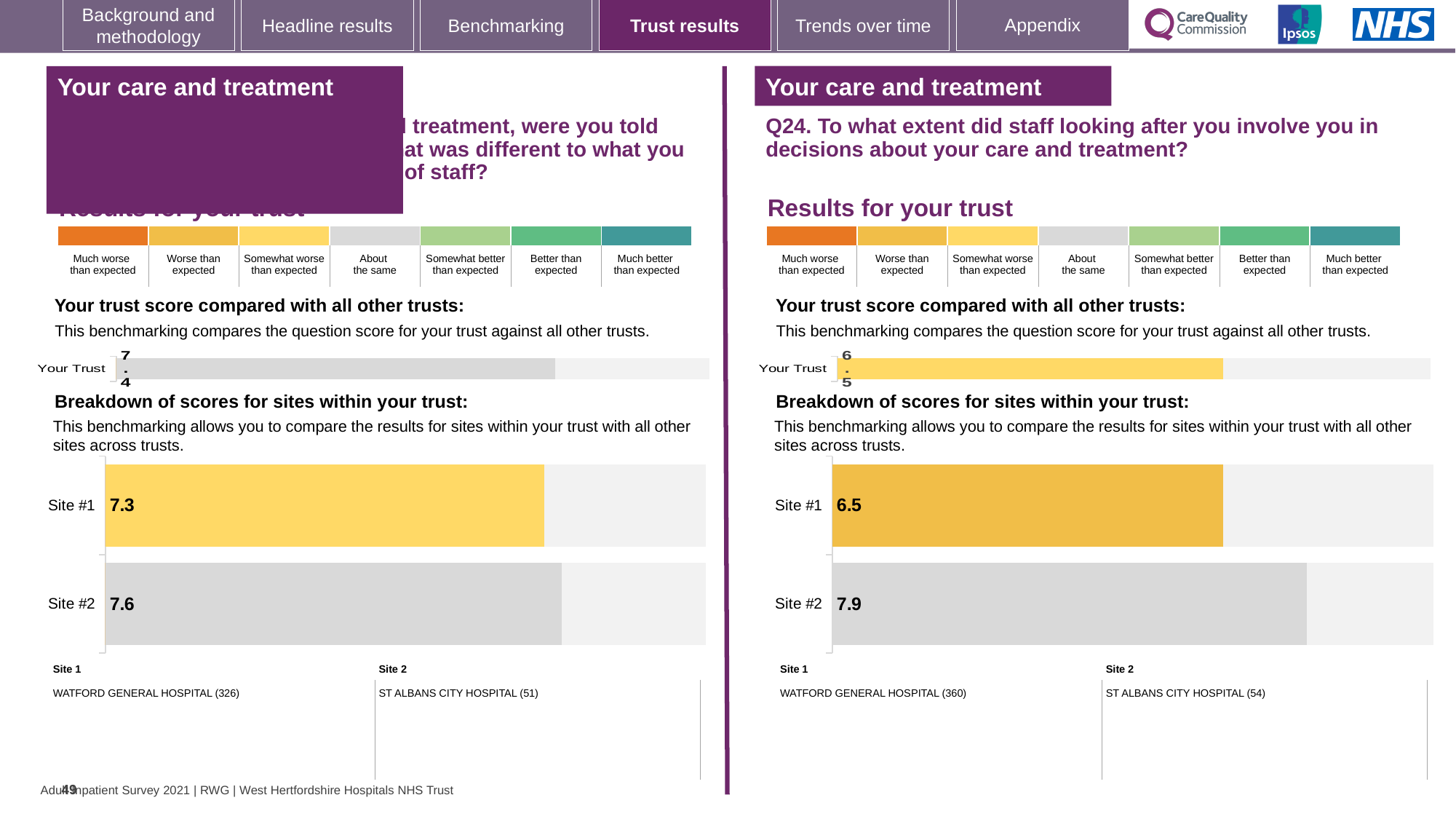
On the left-hand chart, what is the score for Site #2? 7.6 On the left-hand chart, what is the score for Site #1? 7.3 On the right-hand chart (Q24), what is the score for Site #1? 6.5 On the right-hand chart (Q24), what is the 'Your Trust' score? 6.5 On the right-hand chart (Q24), what is the difference between the Site #2 and Site #1 scores? 1.4 On the right-hand chart (Q24), which site has the higher score? Site #2 On the right-hand chart (Q24), what is the score for Site #2? 7.9 On the left-hand chart, what is the 'Your Trust' score? 7.4 On the left-hand chart, what is the difference between the Site #2 and Site #1 scores? 0.3 What type of chart is used for the site breakdown on the left-hand side? Bar chart How many sites are shown in the site breakdown chart on the right-hand side (Q24)? 2 On the left-hand chart, which site has the lower score? Site #1